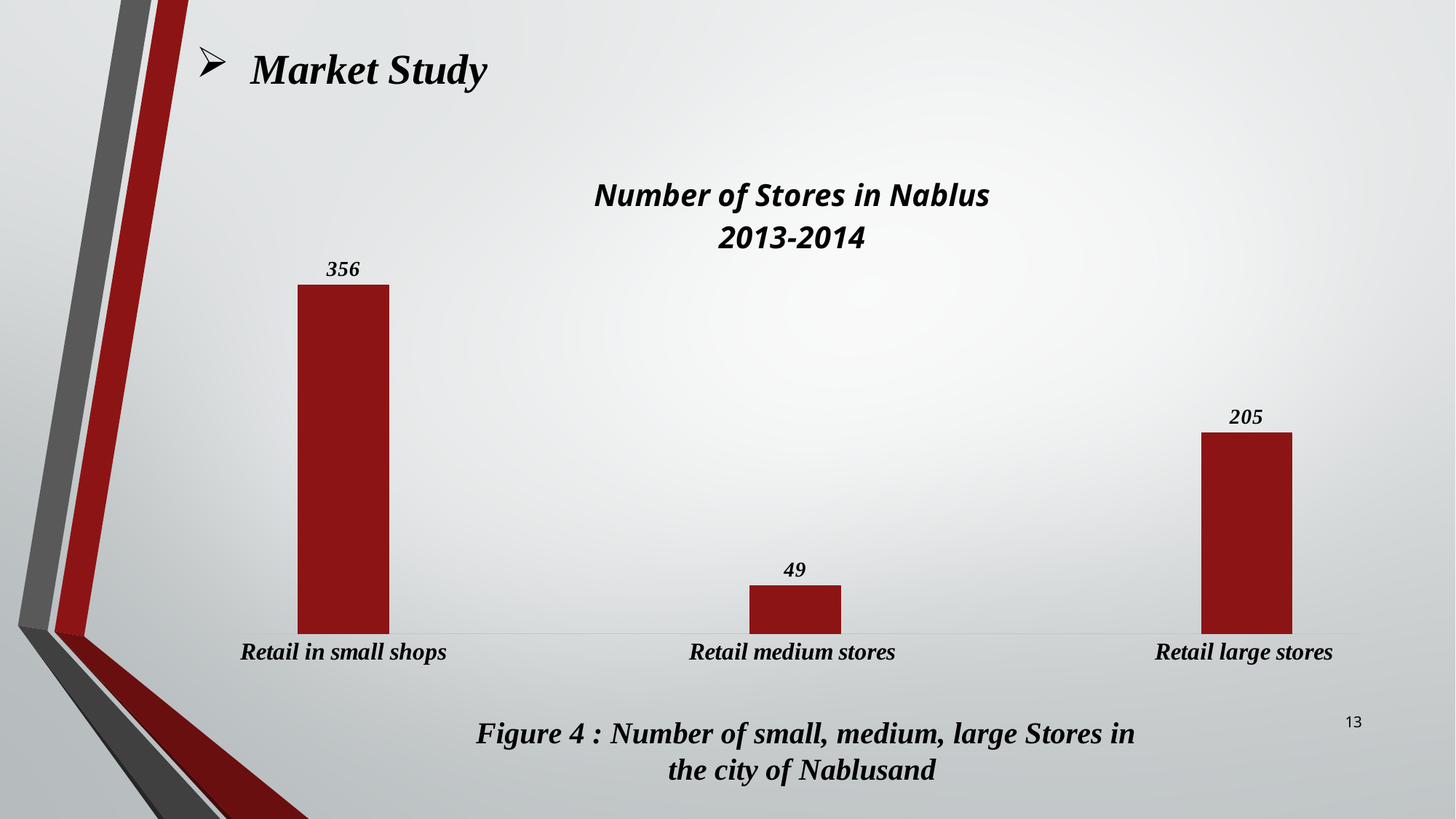
How many categories are shown in the chart? 3 What is the number of stores for Retail large stores? 205 Which has more stores, Retail medium stores or Retail large stores? Retail large stores What is the number of stores for Retail medium stores? 49 Which category has the lowest number of stores? Retail medium stores What is the title of the chart? Number of Stores in Nablus 2013-2014 What is the difference between the number of stores for Retail in small shops and Retail large stores? 151 What kind of chart is shown on the slide? Bar chart Which category has the highest number of stores? Retail in small shops What is the number of stores for Retail in small shops? 356 What is the difference between the number of stores for Retail large stores and Retail medium stores? 156 What colour are the bars in the chart? Dark red